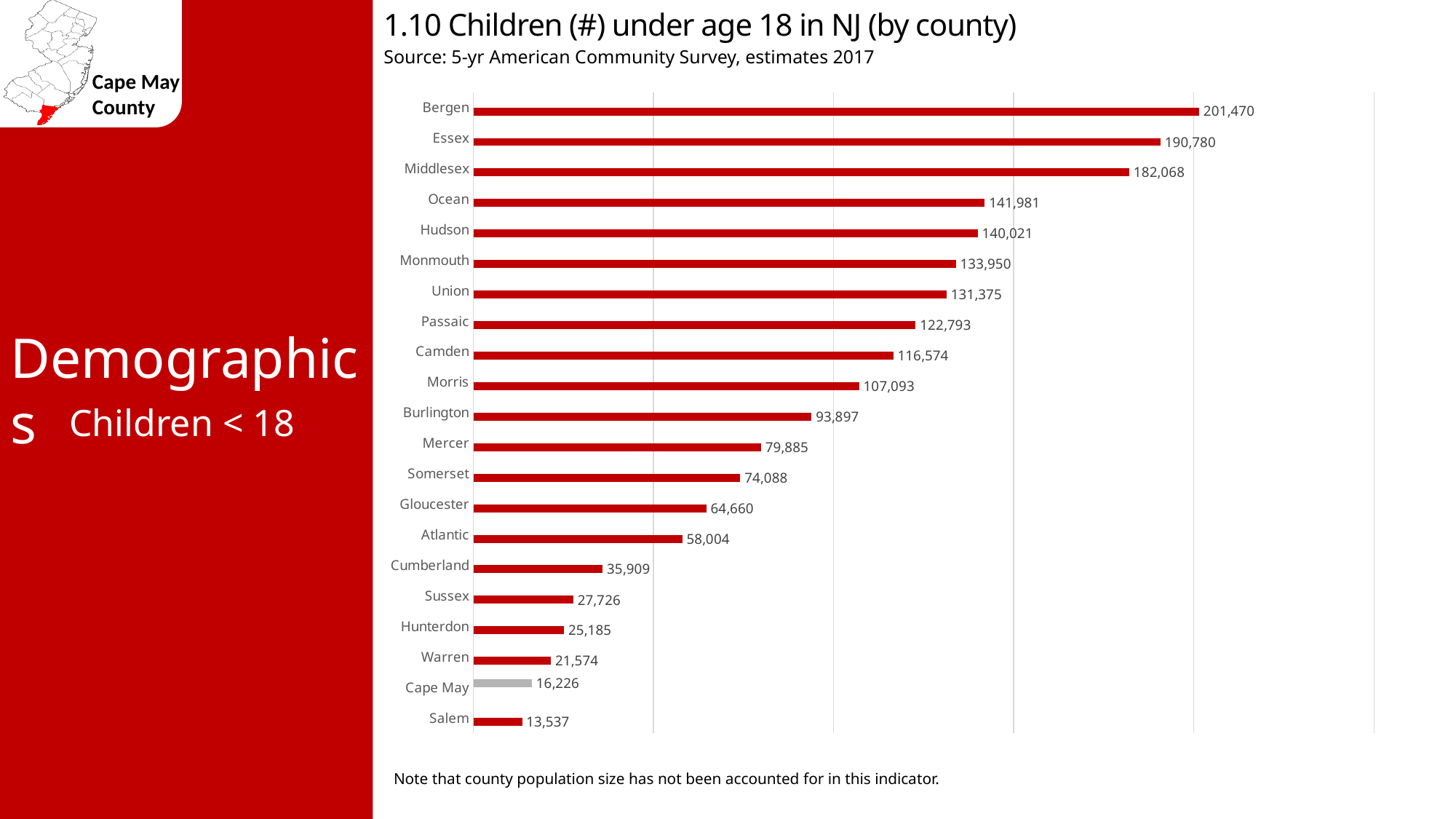
How many counties are shown in the chart? 21 What is the difference between the number of children under 18 in Bergen and Essex counties? 10,690 What is the number of children under age 18 in Atlantic County? 58,004 What is the number of children under age 18 in Bergen County? 201,470 Which county's bar is shown in grey rather than red? Cape May Which county has more children under age 18, Ocean or Hudson? Ocean Which county has the highest number of children under age 18? Bergen Which county has the lowest number of children under age 18? Salem What type of chart is shown on the slide? Bar chart What is the number of children under age 18 in Cape May County? 16,226 Which county has more children under age 18, Gloucester or Mercer? Mercer What is the difference between the number of children under 18 in Cape May and Salem counties? 2,689